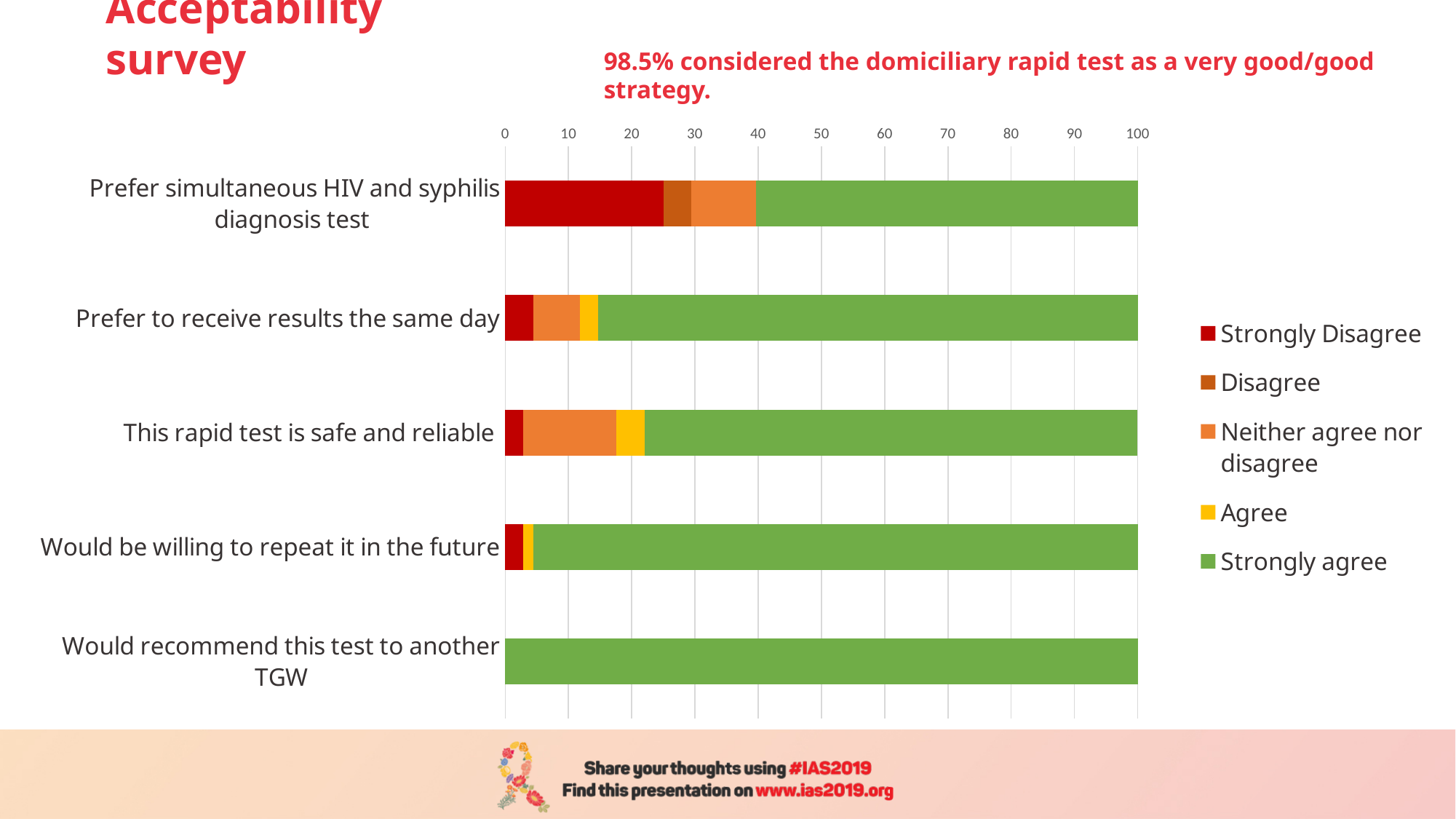
How many series does the chart legend list? 5 Is the 'Strongly Disagree' segment for 'Prefer simultaneous HIV and syphilis diagnosis test' greater or less than 20? greater What is the total length of the stacked bar for 'Would recommend this test to another TGW'? 100 What colour represents 'Strongly agree' in the legend? Green Which has the larger 'Strongly Disagree' segment: 'Prefer simultaneous HIV and syphilis diagnosis test' or 'Prefer to receive results the same day'? Prefer simultaneous HIV and syphilis diagnosis test Is the 'Strongly agree' segment for 'This rapid test is safe and reliable' greater or less than 70? greater According to the red text above the chart, what percentage considered the domiciliary rapid test a very good/good strategy? 98.5% Is the 'Strongly Disagree' segment for 'Would be willing to repeat it in the future' greater or less than 10? less Which category has the smallest 'Strongly agree' segment? Prefer simultaneous HIV and syphilis diagnosis test Which category has the largest 'Strongly agree' segment? Would recommend this test to another TGW What kind of chart is shown on the slide? Stacked bar chart How many survey statements (categories) are plotted on the chart? 5